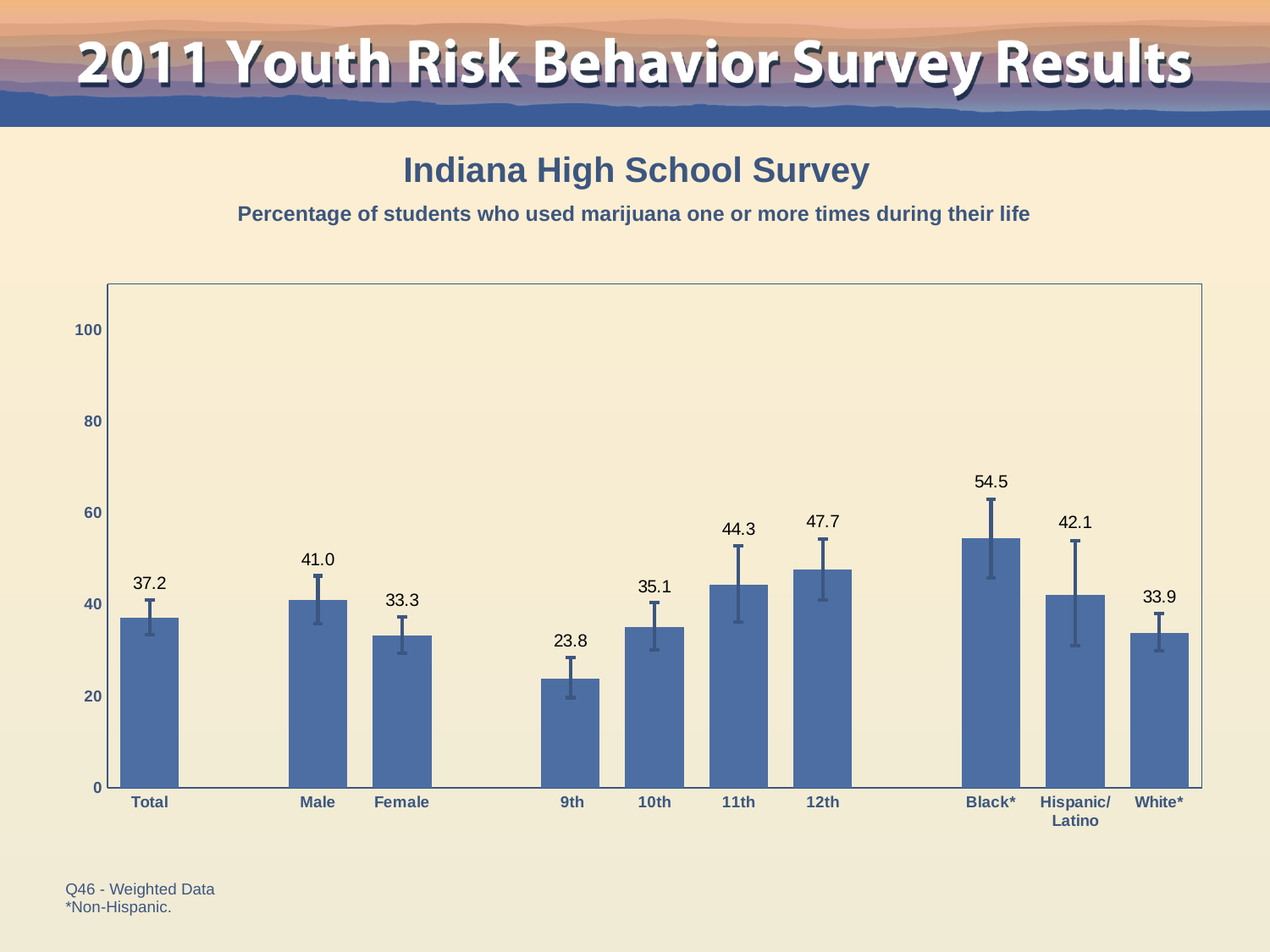
Is the value for White* greater or less than 40? less What is the difference between the values for Male and Female? 7.7 Which category has the lowest value? 9th Which is larger, the value for 11th or the value for 12th? 12th Which category has the highest value? Black* What is the difference between the values for 12th and 9th grade? 23.9 What is the value for Total? 37.2 What is the value for Hispanic/Latino students? 42.1 How many categories are shown in the chart? 10 What kind of chart is shown on the slide? bar chart What is the value for 9th grade students? 23.8 Do the values rise or fall from 9th grade to 12th grade? rise